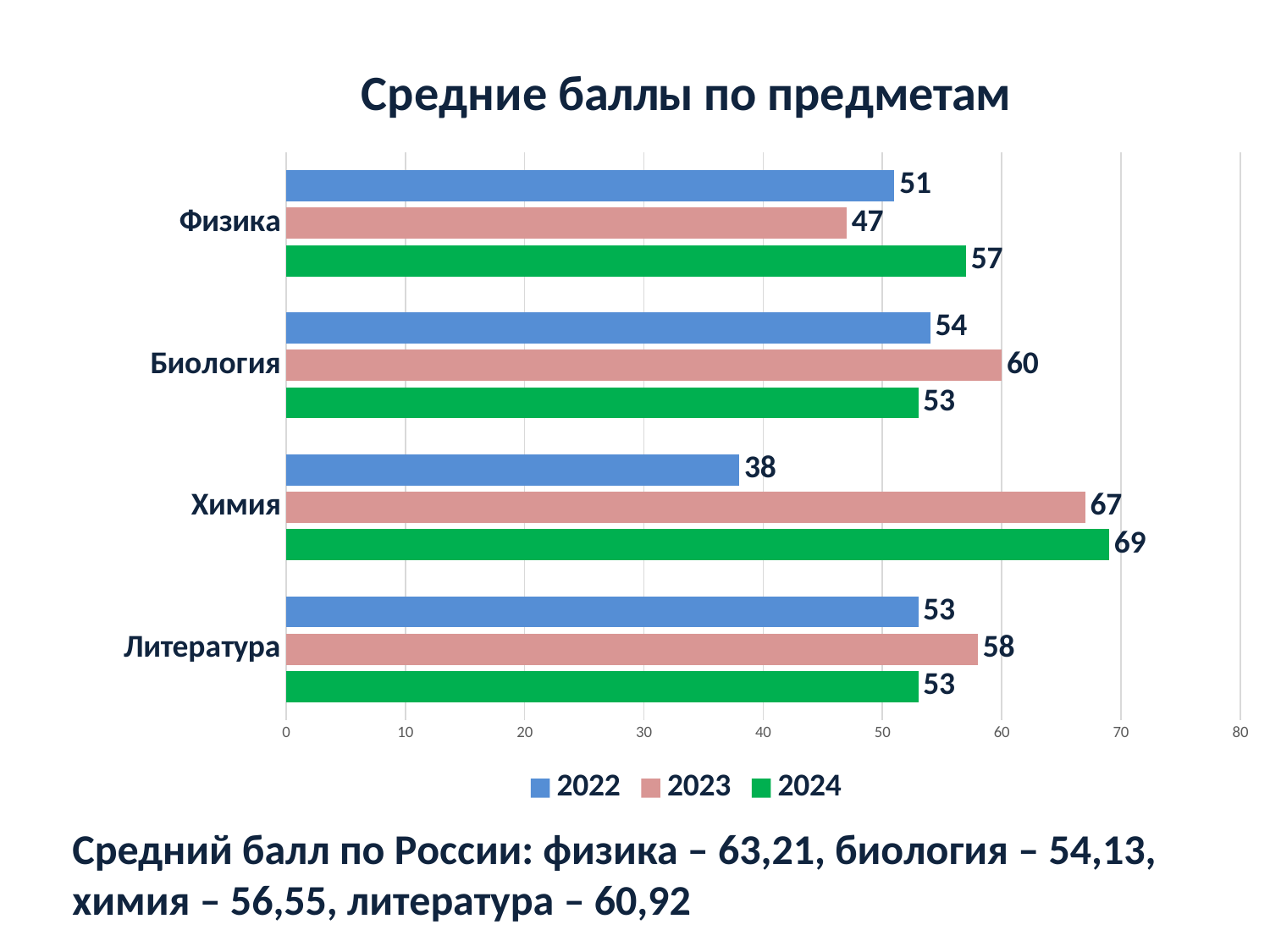
What is the difference between the 2024 and 2022 values for Химия? 31 How many series does the legend list? 3 Which subject has the lowest value in 2022? Химия What is the value for Биология in 2023? 60 What is the value for Физика in 2024? 57 Which subject has the highest value in 2024? Химия What is the value for Химия in 2022? 38 What is the title of the chart? Средние баллы по предметам Is the value for Физика in 2023 greater or less than 50? less How many subjects are shown on the chart? 4 Which is larger for Литература: the 2023 value or the 2022 value? 2023 What kind of chart is shown on the slide? bar chart